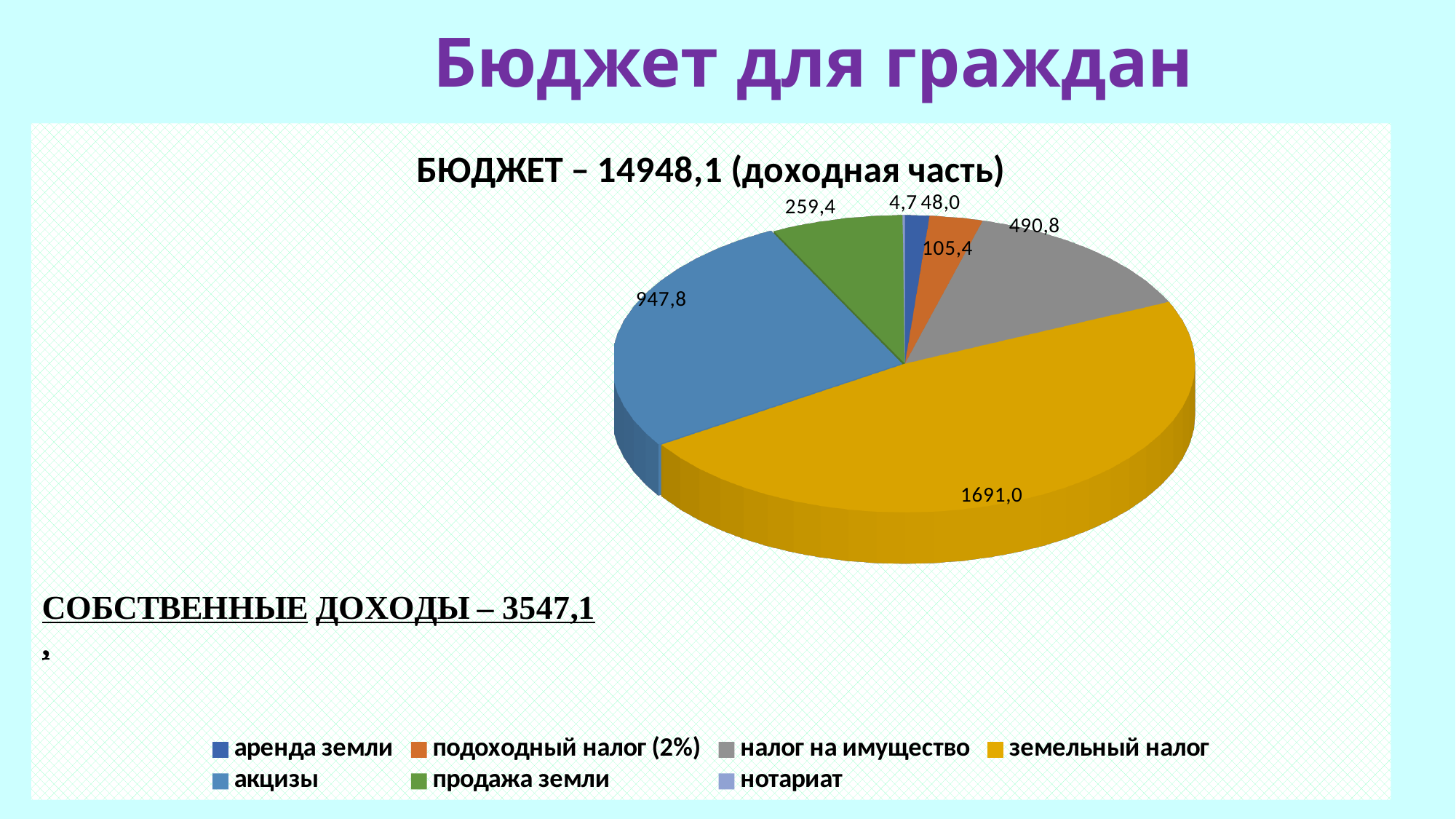
Which is larger, акцизы or налог на имущество? акцизы What colour is the slice for земельный налог? Yellow What is the value for подоходный налог (2%)? 105,4 What is the value for земельный налог? 1691,0 What type of chart is shown on the slide? Pie chart What is the value for акцизы? 947,8 What is the value for продажа земли? 259,4 How many categories does the chart legend list? 7 What is the value for налог на имущество? 490,8 What is the difference between земельный налог and акцизы? 743,2 What is the title of the chart? БЮДЖЕТ – 14948,1 (доходная часть) Which category has the largest slice of the pie? земельный налог